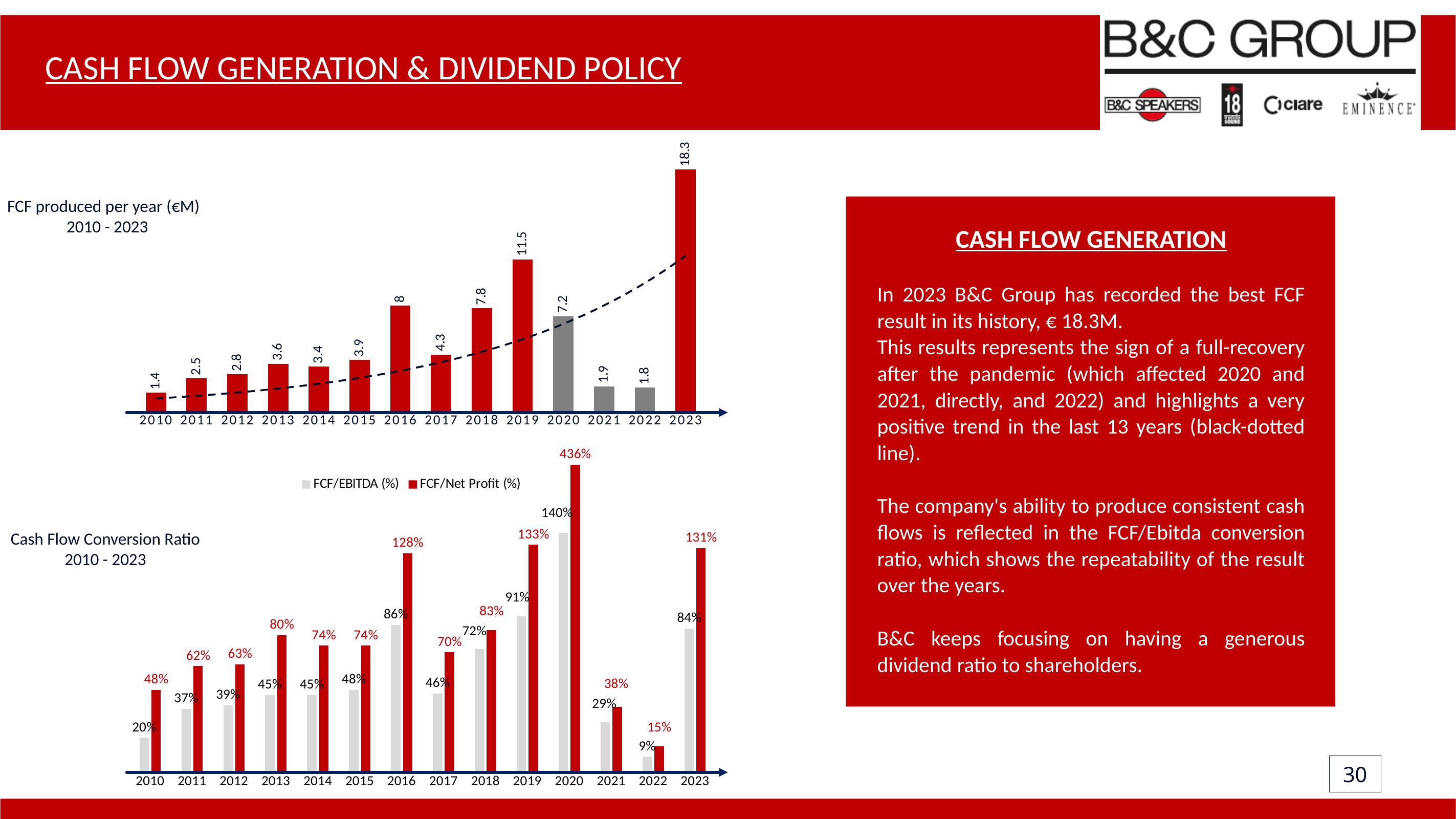
In the 'FCF produced per year (€M)' chart, what is the value for 2021? 1.9 What type of chart is the 'FCF produced per year (€M)' chart? bar chart In the 'Cash Flow Conversion Ratio' chart, what is the difference between the FCF/Net Profit (%) and FCF/EBITDA (%) values for 2023? 47% In the 'FCF produced per year (€M)' chart, which is larger, the value for 2016 or the value for 2020? 2016 How many years are shown on the x axis of the 'FCF produced per year (€M)' chart? 14 In the 'Cash Flow Conversion Ratio' chart, what is the FCF/EBITDA (%) value for 2022? 9% In the 'FCF produced per year (€M)' chart, what is the difference between the 2019 and 2018 values? 3.7 How many series does the legend of the 'Cash Flow Conversion Ratio' chart list? 2 In the 'FCF produced per year (€M)' chart, which year has the lowest value? 2010 In the 'FCF produced per year (€M)' chart, what is the value for 2023? 18.3 In the 'Cash Flow Conversion Ratio' chart, what is the FCF/Net Profit (%) value for 2020? 436% In the 'Cash Flow Conversion Ratio' chart, which year has the highest FCF/EBITDA (%) value? 2020